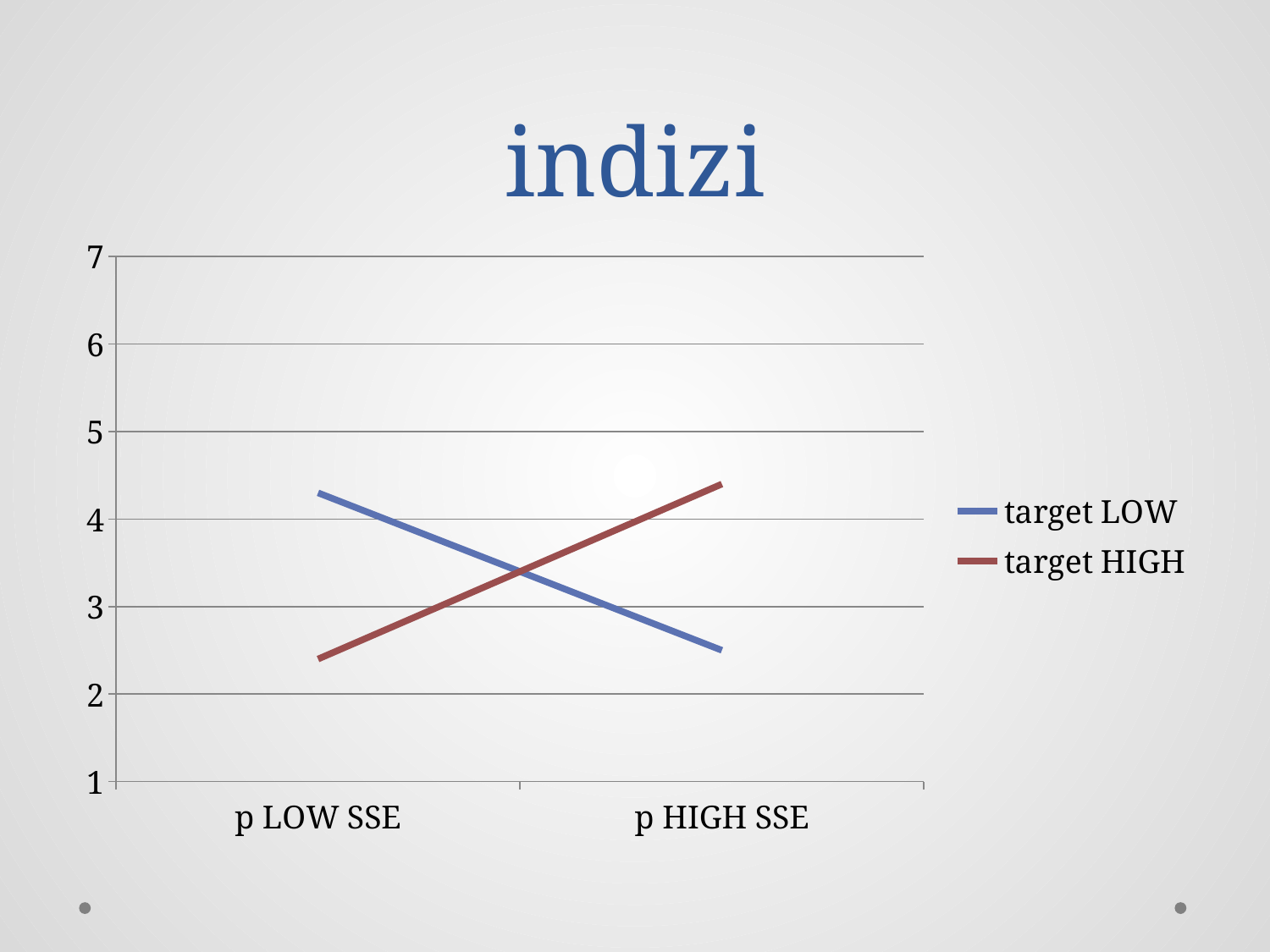
What is the title of the slide? indizi How many categories are shown on the x axis? 2 Does the target HIGH line rise or fall from p LOW SSE to p HIGH SSE? rise Does the target LOW line rise or fall from p LOW SSE to p HIGH SSE? fall At p LOW SSE, which series has the larger value, target LOW or target HIGH? target LOW Is the value for target LOW at p LOW SSE greater or less than 4? greater How many series does the legend list? 2 Is the value for target LOW at p HIGH SSE greater or less than 3? less What kind of chart is shown on the slide? line chart Is the value for target HIGH at p HIGH SSE greater or less than 4? greater At p HIGH SSE, which series has the larger value, target LOW or target HIGH? target HIGH